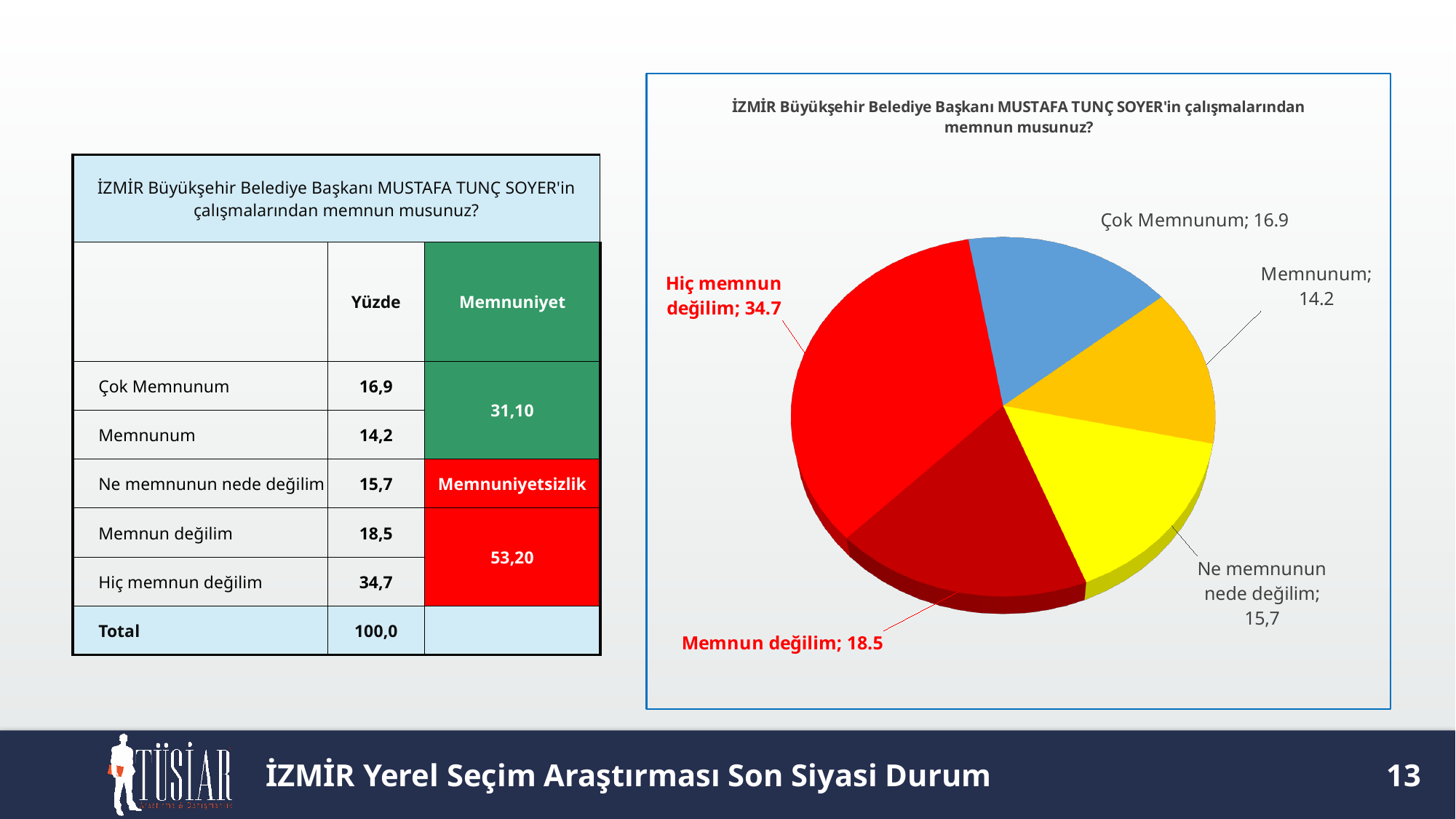
Which category has the largest slice in the pie chart? Hiç memnun değilim What type of chart is shown on the slide? Pie chart What is the value for "Çok Memnunum" in the pie chart? 16.9 What is the difference between the values for "Hiç memnun değilim" and "Memnun değilim"? 16.2 How many slices does the pie chart have? 5 What share of the pie does the "Memnun değilim" slice represent? 18.5 What colour is the "Çok Memnunum" slice in the pie chart? Blue What is the value for "Memnunum" in the pie chart? 14.2 What is the value for "Hiç memnun değilim" in the pie chart? 34.7 Which category has the smallest slice in the pie chart? Memnunum Which is larger in the pie chart: "Çok Memnunum" or "Memnunum"? Çok Memnunum What is the value for "Ne memnunun nede değilim" in the pie chart? 15,7